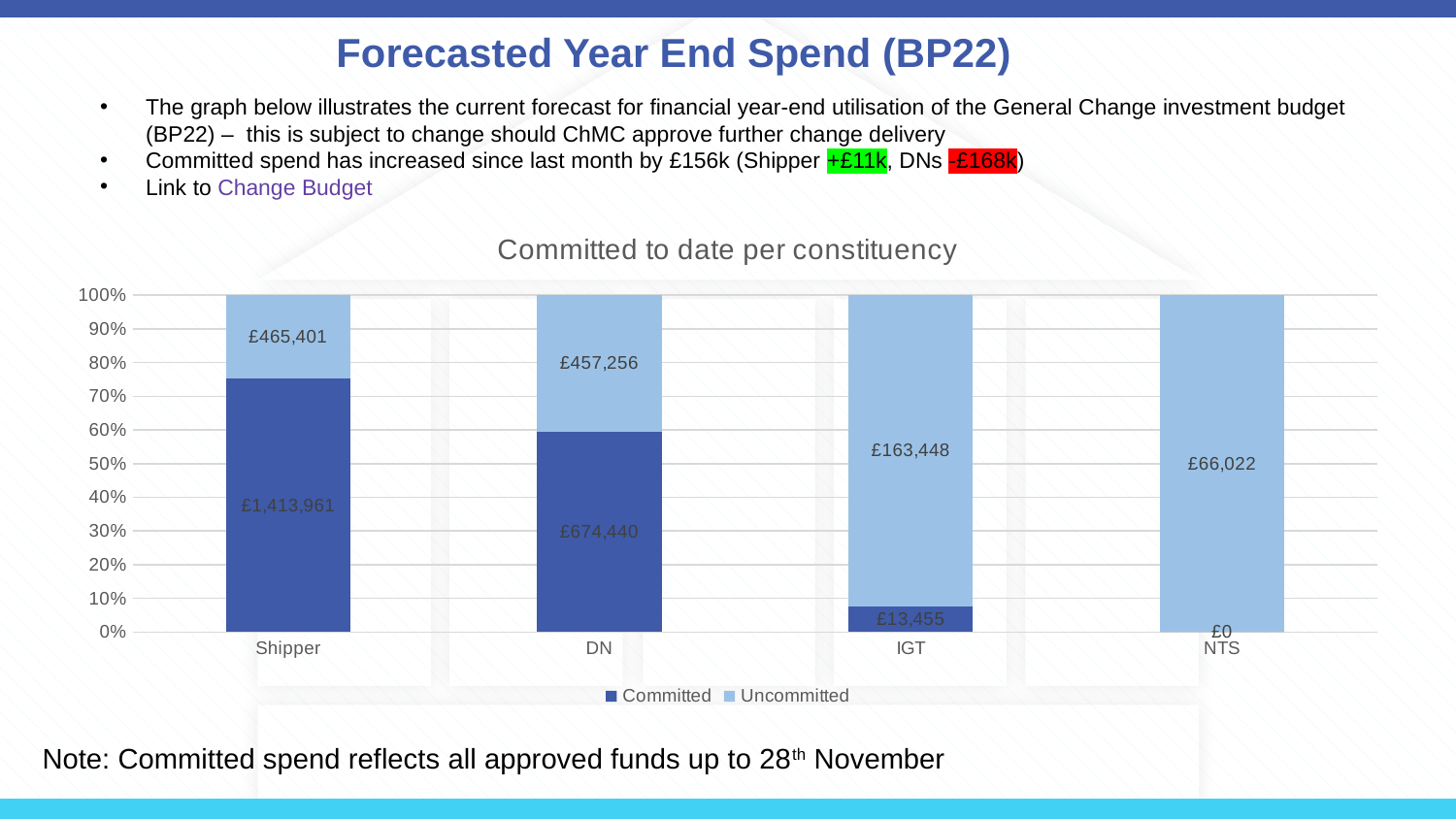
Which constituency has the lowest Uncommitted value? NTS What is the total of the Committed and Uncommitted values for DN? £1,131,696 What is the Committed value for IGT? £13,455 What is the Committed value for Shipper? £1,413,961 What is the Uncommitted value for NTS? £66,022 How many constituencies are shown on the x axis? 4 Which is larger for DN, the Committed value or the Uncommitted value? Committed Which constituency has the highest Committed value? Shipper What is the difference between the Committed and Uncommitted values for Shipper? £948,560 Is the Committed share of the Shipper bar greater or less than 70%? greater How many series does the legend list? 2 What is the Uncommitted value for DN? £457,256